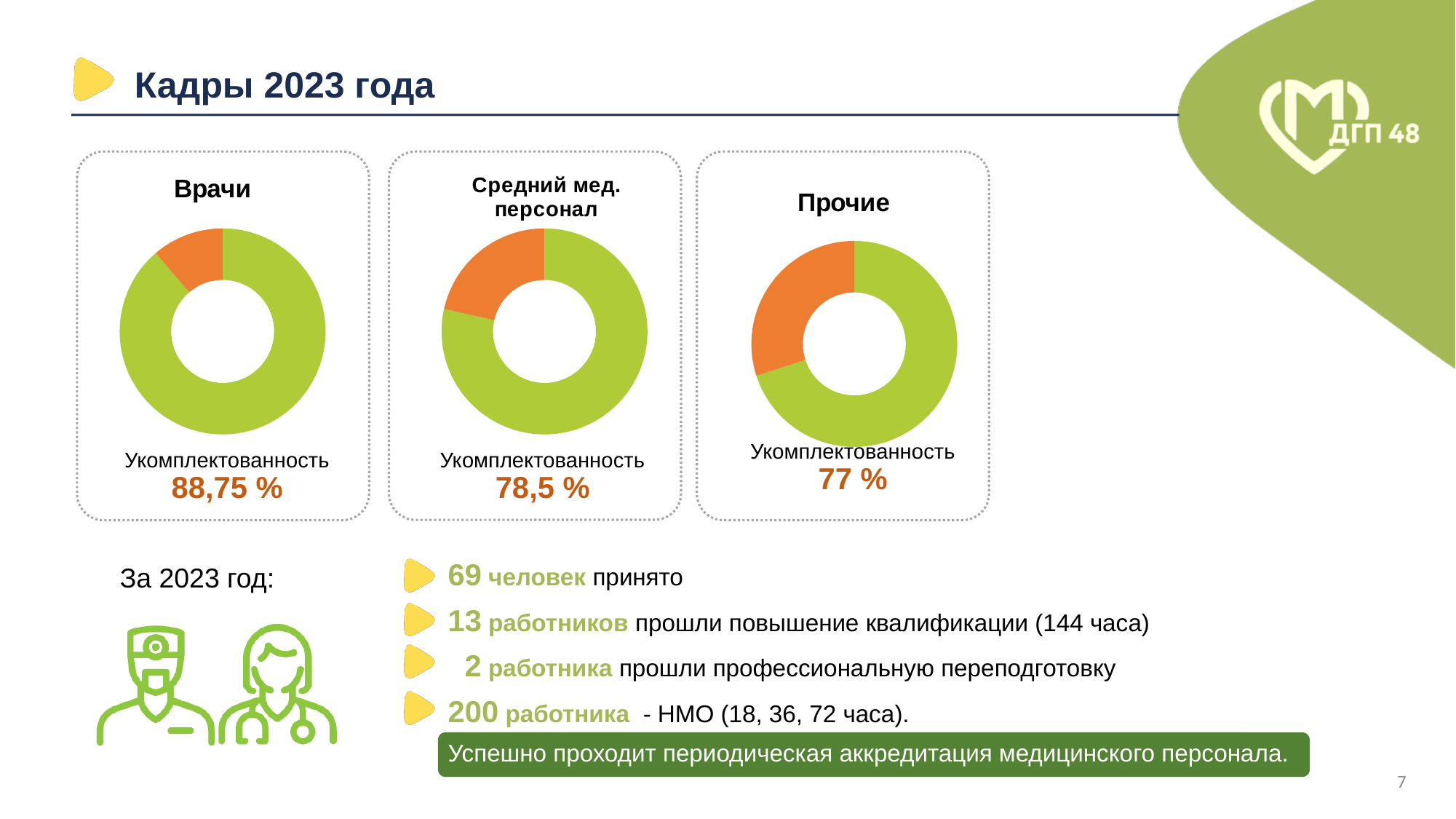
What is the difference in staffing level between the 'Врачи' chart and the 'Средний мед. персонал' chart? 10,25 % What two colours are used for the slices in each donut chart? Green and orange Across the three charts, which staff category has the highest staffing level? Врачи What type of chart is used for each staff category on the slide? Donut (pie) chart In the 'Средний мед. персонал' chart, what is the staffing level (Укомплектованность) shown? 78,5 % In the 'Прочие' chart, what is the staffing level (Укомплектованность) shown? 77 % In the 'Врачи' chart, what is the staffing level (Укомплектованность) shown? 88,75 % How many donut charts are shown on the slide? 3 What is the difference in staffing level between the 'Врачи' chart and the 'Прочие' chart? 11,75 % What is the difference in staffing level between the 'Средний мед. персонал' chart and the 'Прочие' chart? 1,5 % Across the three charts, which staff category has the lowest staffing level? Прочие Which has a higher staffing level: 'Врачи' or 'Прочие'? Врачи